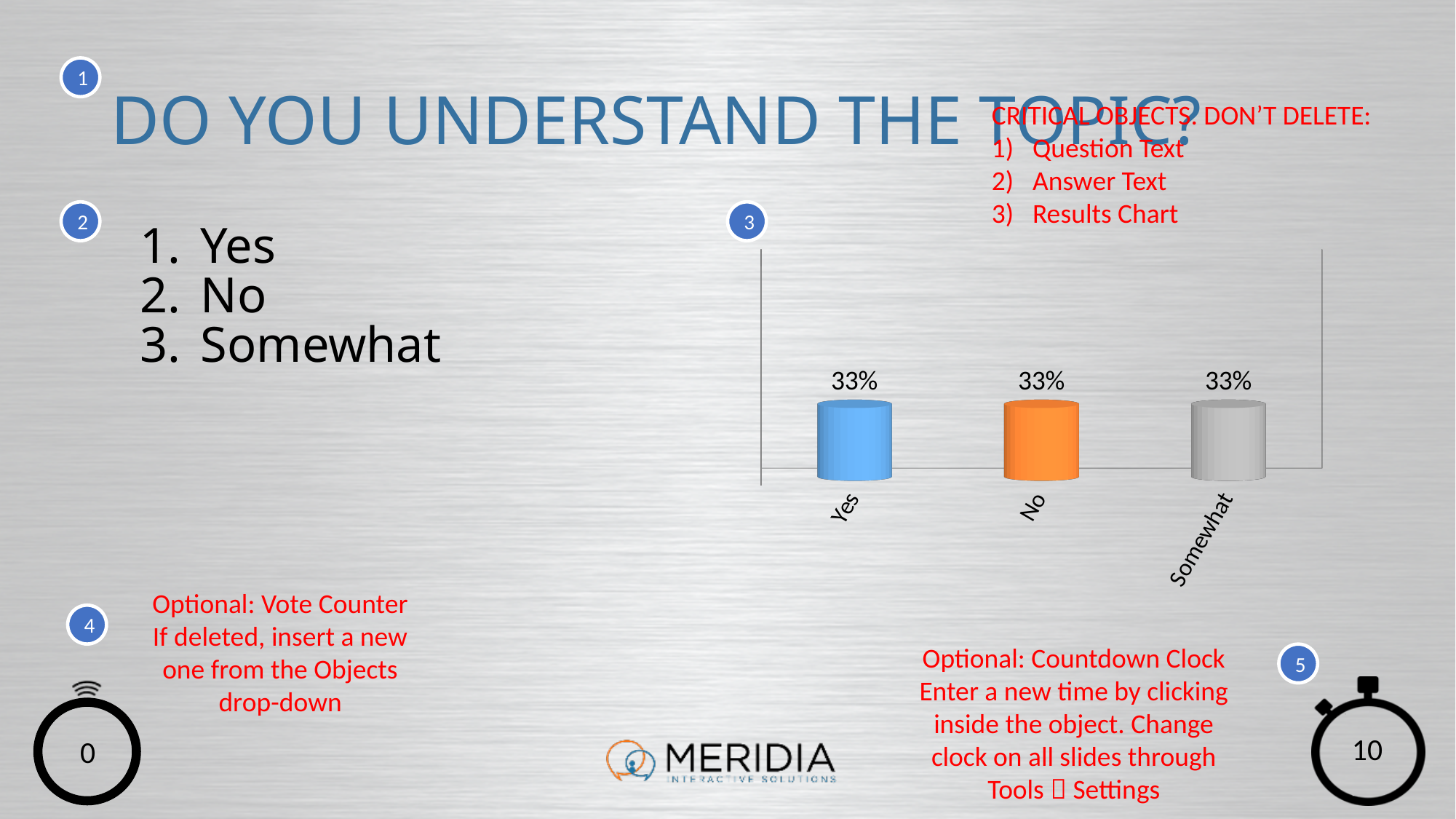
Do the values rise, fall, or stay the same across the categories from Yes to Somewhat? stay the same What is the difference between the values for Yes and No? 0 What is the value for Somewhat? 33% How many categories are shown on the chart? 3 What colour is the bar for No? orange What kind of chart is shown on the slide? bar chart What is the value for Yes? 33% What is the value for No? 33% What is the total of the values for Yes, No and Somewhat? 99% Which category is represented by the blue bar? Yes